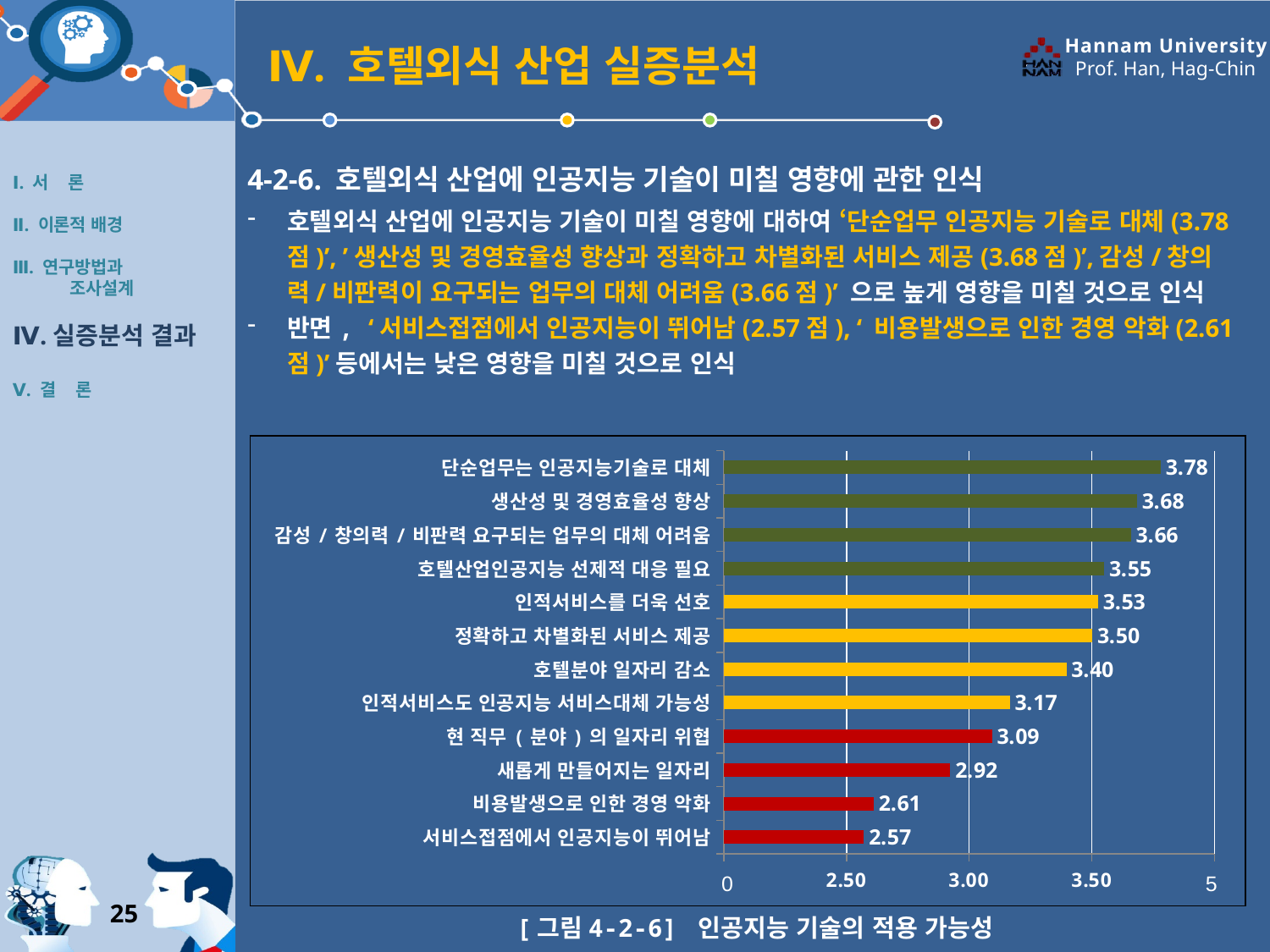
Which category has the highest value? 단순업무는 인공지능기술로 대체 What is the value for '호텔분야 일자리 감소'? 3.40 What is the caption of the chart shown on the slide? [그림 4-2-6] 인공지능 기술의 적용 가능성 What kind of chart is shown on the slide? Bar chart What is the value for '단순업무는 인공지능기술로 대체'? 3.78 What is the value for '새롭게 만들어지는 일자리'? 2.92 What is the difference between the values for '호텔산업인공지능 선제적 대응 필요' and '인적서비스를 더욱 선호'? 0.02 Is the value for '인적서비스도 인공지능 서비스대체 가능성' greater or less than 3.00? greater How many categories are shown in the chart? 12 Which category has the lowest value? 서비스접점에서 인공지능이 뛰어남 Which is larger, the value for '현 직무(분야)의 일자리 위협' or the value for '비용발생으로 인한 경영 악화'? 현 직무(분야)의 일자리 위협 What is the difference between the values for '단순업무는 인공지능기술로 대체' and '서비스접점에서 인공지능이 뛰어남'? 1.21